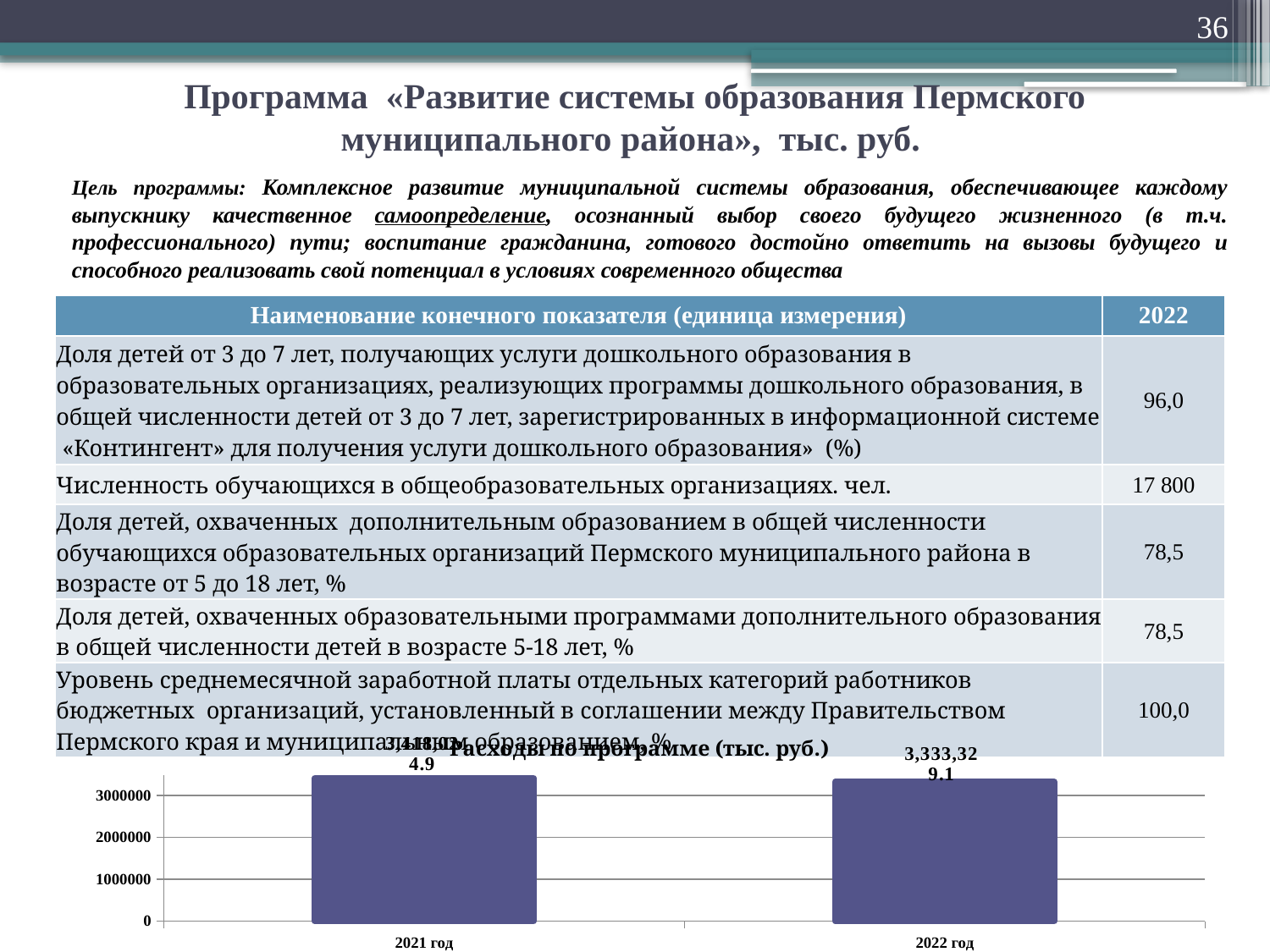
Is the value for 2022 год in the chart greater or less than 2000000? greater Is the value for 2021 год in the chart greater or less than 3000000? greater What kind of chart is shown at the bottom of the slide? bar chart Which years are shown on the x axis of the chart? 2021 год, 2022 год How many bars are plotted in the chart "Расходы по программе (тыс. руб.)"? 2 What is the title of the chart at the bottom of the slide? Расходы по программе (тыс. руб.) Is the value for 2022 год in the chart greater or less than 3000000? greater What is the highest tick value shown on the y axis of the chart? 3000000 What is the data label shown for 2022 год in the chart? 3,333,329.1